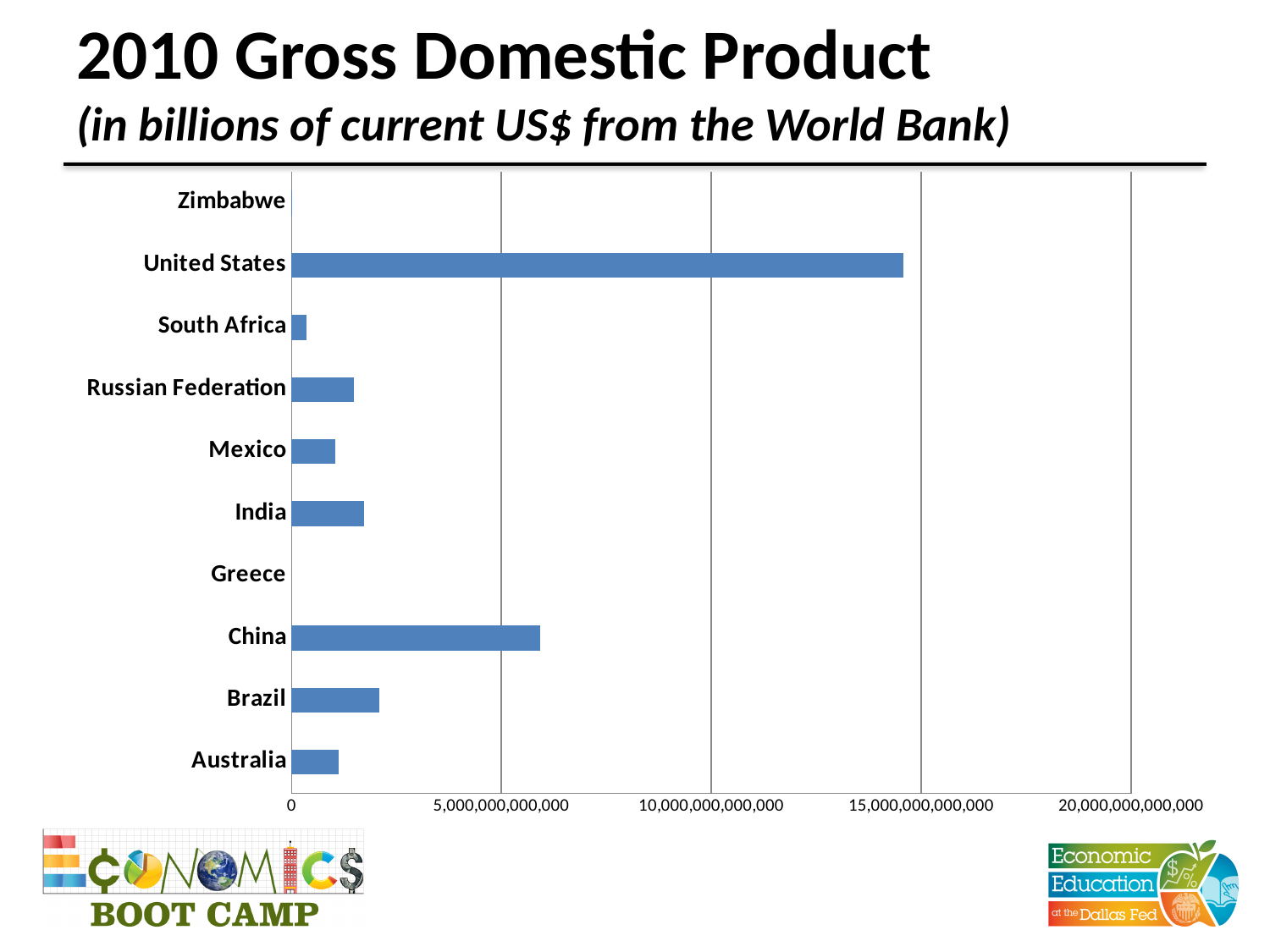
What is the title of the chart on the slide? 2010 Gross Domestic Product Is the value for the United States greater or less than 10,000,000,000,000? greater Which has the larger value, Russian Federation or South Africa? Russian Federation Which has the larger value, India or Mexico? India Is the value for China greater or less than 5,000,000,000,000? greater Is the value for Brazil greater or less than 5,000,000,000,000? less How many countries are plotted in the chart? 10 Which country has the highest 2010 GDP in the chart? United States What kind of chart is shown on the slide? bar chart Which country has the second-longest bar in the chart? China Which has the larger value, China or Brazil? China